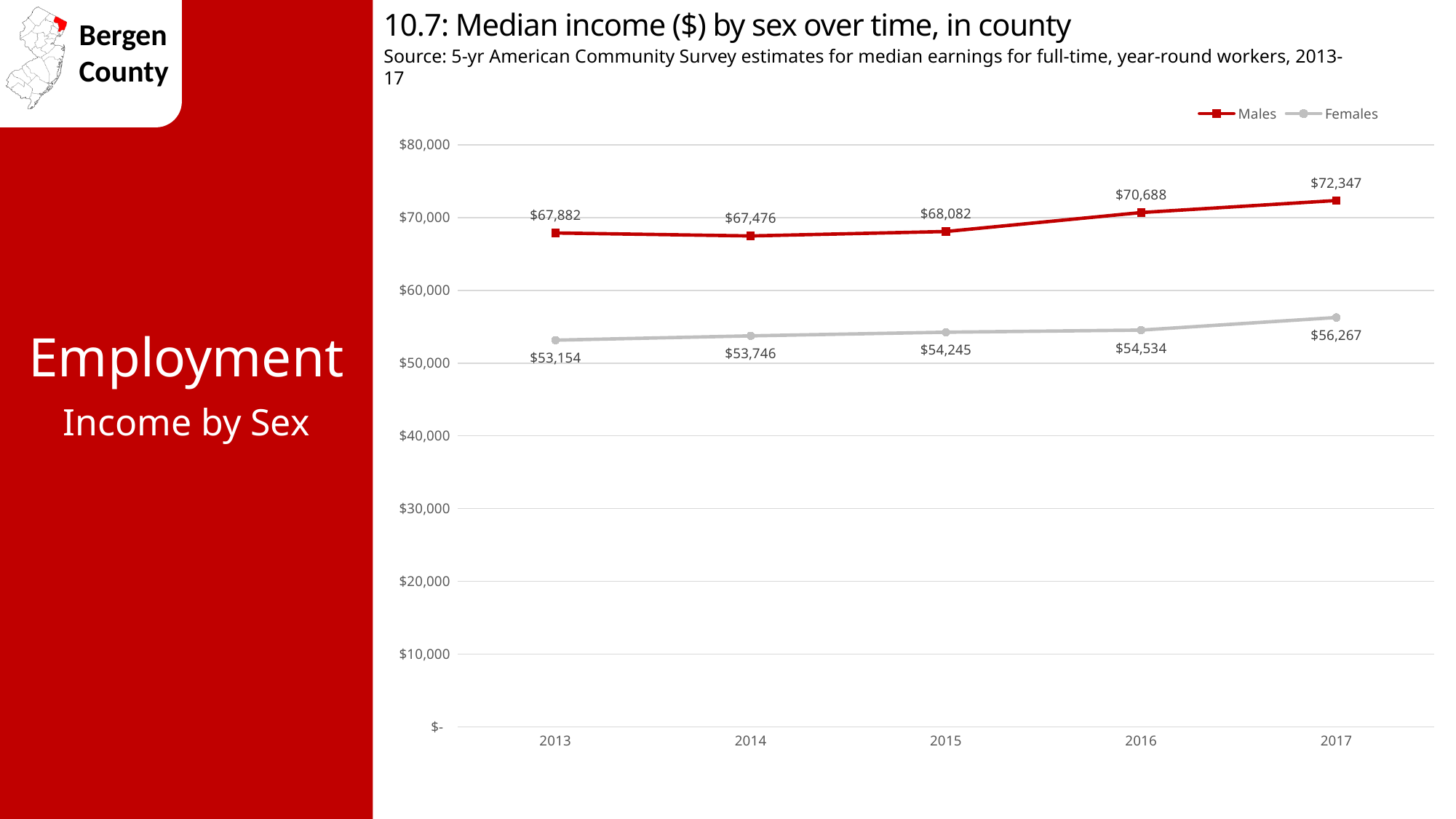
What was the median income for Females in 2016? $54,534 What kind of chart is shown on the slide? Line chart What is the difference between the Males median income in 2016 and in 2015? $2,606 Which series had the higher median income in 2015, Males or Females? Males In which year was the median income for Females the highest? 2017 What was the median income for Females in 2013? $53,154 How many series does the legend list? 2 What was the median income for Males in 2017? $72,347 In which year was the median income for Males the lowest? 2014 How many years are shown on the x axis? 5 What was the median income for Males in 2014? $67,476 What is the difference between the Males and Females median income in 2017? $16,080